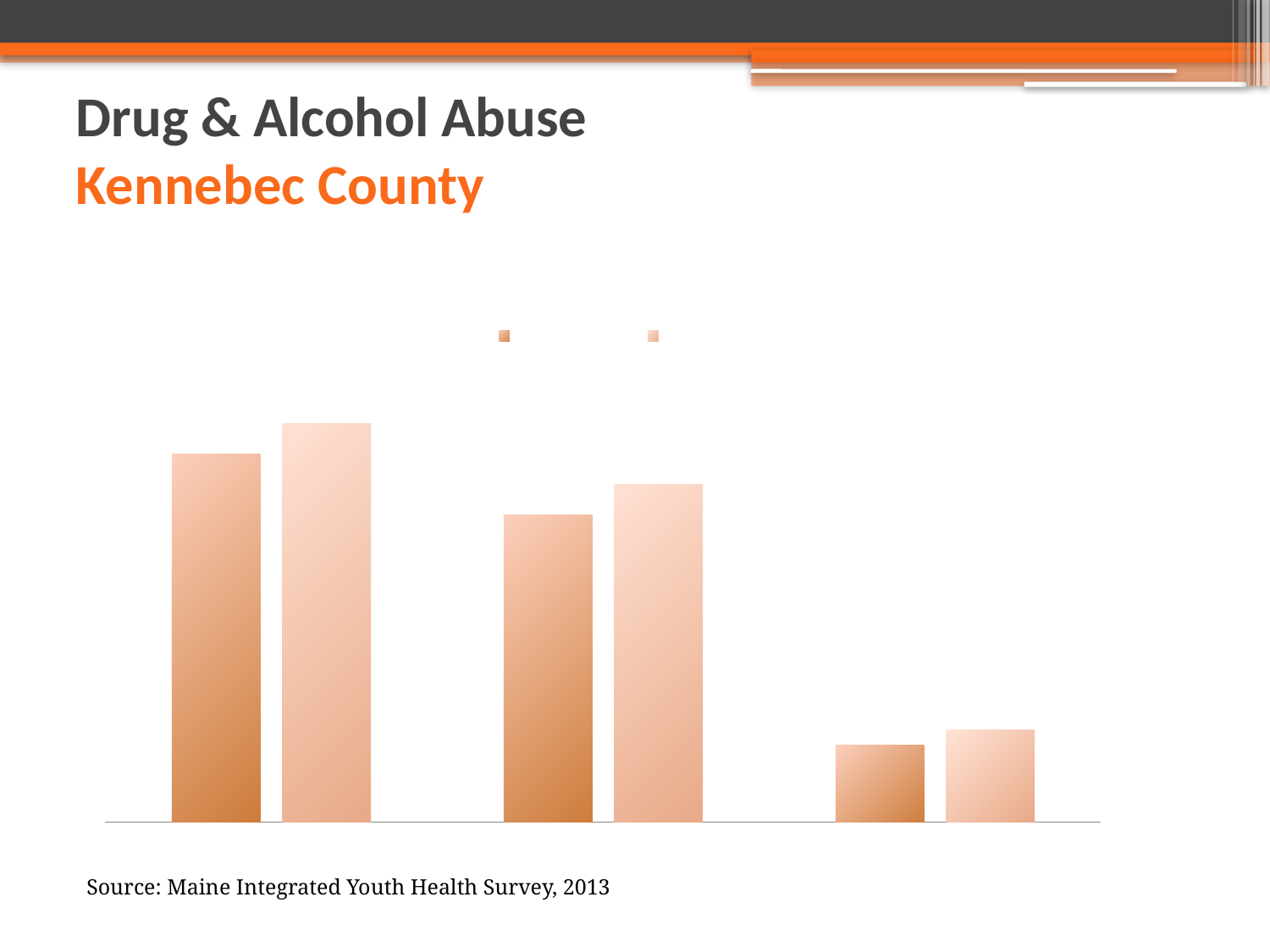
Which group of bars has the tallest bar in the chart: the leftmost, middle, or rightmost group? the leftmost group Which group of bars has the shortest bar in the chart: the leftmost, middle, or rightmost group? the rightmost group Do the lighter orange bars rise or fall from left to right across the chart? fall Is the darker orange bar in the middle group taller or shorter than the darker orange bar in the leftmost group? shorter How many groups of bars are plotted in the chart? 3 In the rightmost group of bars, which bar is taller, the darker orange bar or the lighter orange bar? the lighter orange bar What source is cited below the chart? Maine Integrated Youth Health Survey, 2013 Do the darker orange bars rise or fall from left to right across the chart? fall How many bars in total are plotted in the chart? 6 In the leftmost group of bars, which bar is taller, the darker orange bar or the lighter orange bar? the lighter orange bar How many series does the legend of the chart list? 2 What kind of chart is shown on the slide? bar chart